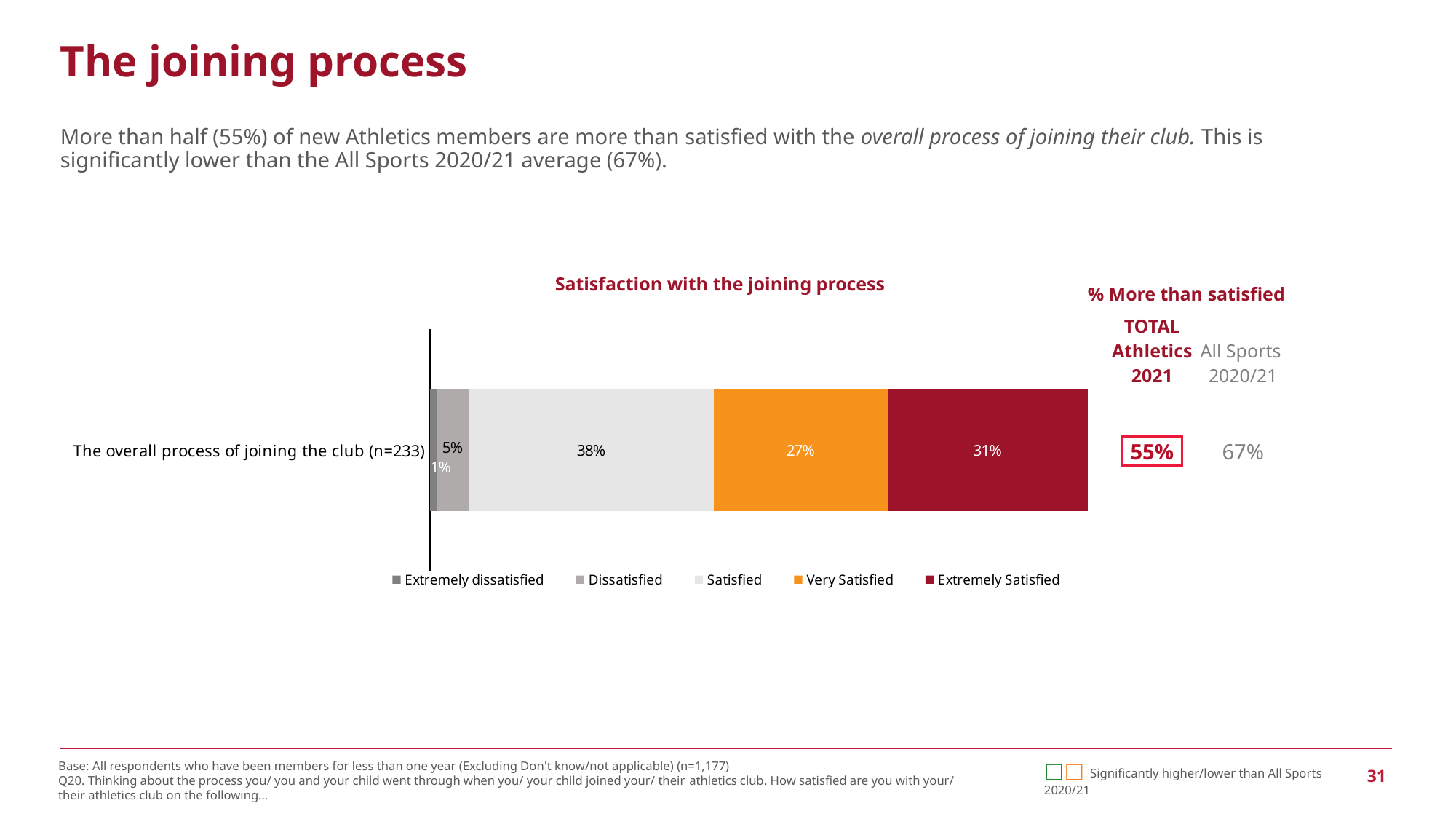
Which satisfaction level has the smallest share of the bar? Extremely dissatisfied What is the difference between the Extremely Satisfied and Very Satisfied percentages? 4% What type of chart is shown on the slide? Stacked bar chart Which satisfaction level has the largest share of the bar? Satisfied What percentage of respondents were Extremely Satisfied with the overall process of joining the club? 31% What is the title of the chart? Satisfaction with the joining process What percentage of respondents were Dissatisfied with the overall process of joining the club? 5% What percentage of respondents were Very Satisfied with the overall process of joining the club? 27% How many categories are plotted on the chart? 1 What percentage of respondents were Extremely dissatisfied with the overall process of joining the club? 1% What percentage of respondents were Satisfied with the overall process of joining the club? 38% How many series does the chart legend list? 5